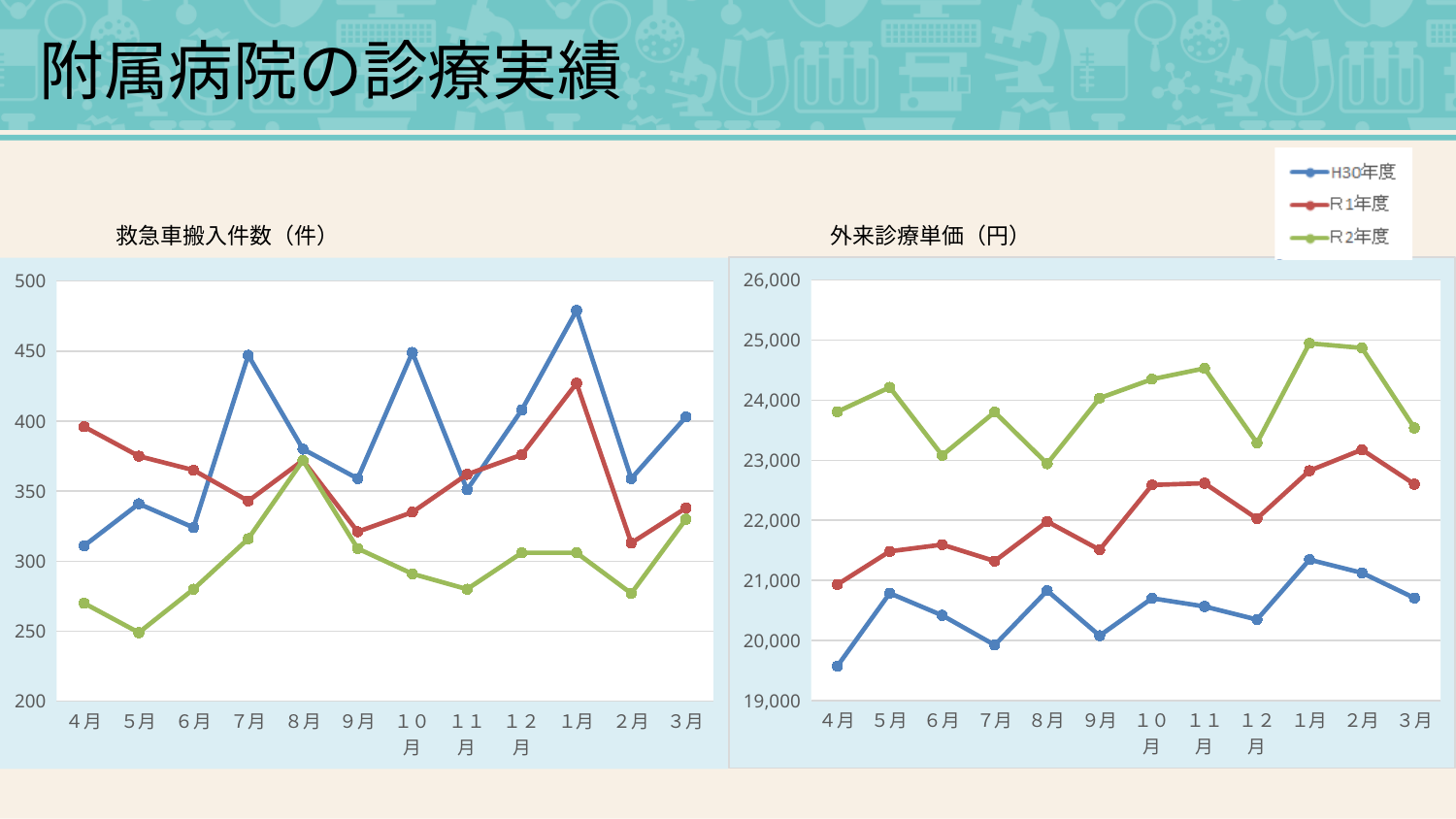
In the left chart (救急車搬入件数), in which month does the H30年度 series reach its highest value? 1月 In the right chart (外来診療単価), is the R2年度 value for 1月 greater or less than 24,000? greater In the left chart (救急車搬入件数), is the H30年度 value for 1月 greater or less than 450? greater In the left chart (救急車搬入件数), how many months are plotted along the x axis? 12 In the left chart (救急車搬入件数), is the R2年度 value for 5月 greater or less than 300? less What kind of chart is the left chart titled 救急車搬入件数（件）? line chart In the left chart (救急車搬入件数), in which month does the R2年度 series reach its lowest value? 5月 In the left chart (救急車搬入件数), which is larger in 7月, the H30年度 value or the R2年度 value? H30年度 In the right chart (外来診療単価), does the H30年度 series rise or fall from 4月 to 5月? rise In the right chart (外来診療単価), which is larger in 3月, the H30年度 value or the R1年度 value? R1年度 How many series does the legend list for the charts on this slide? 3